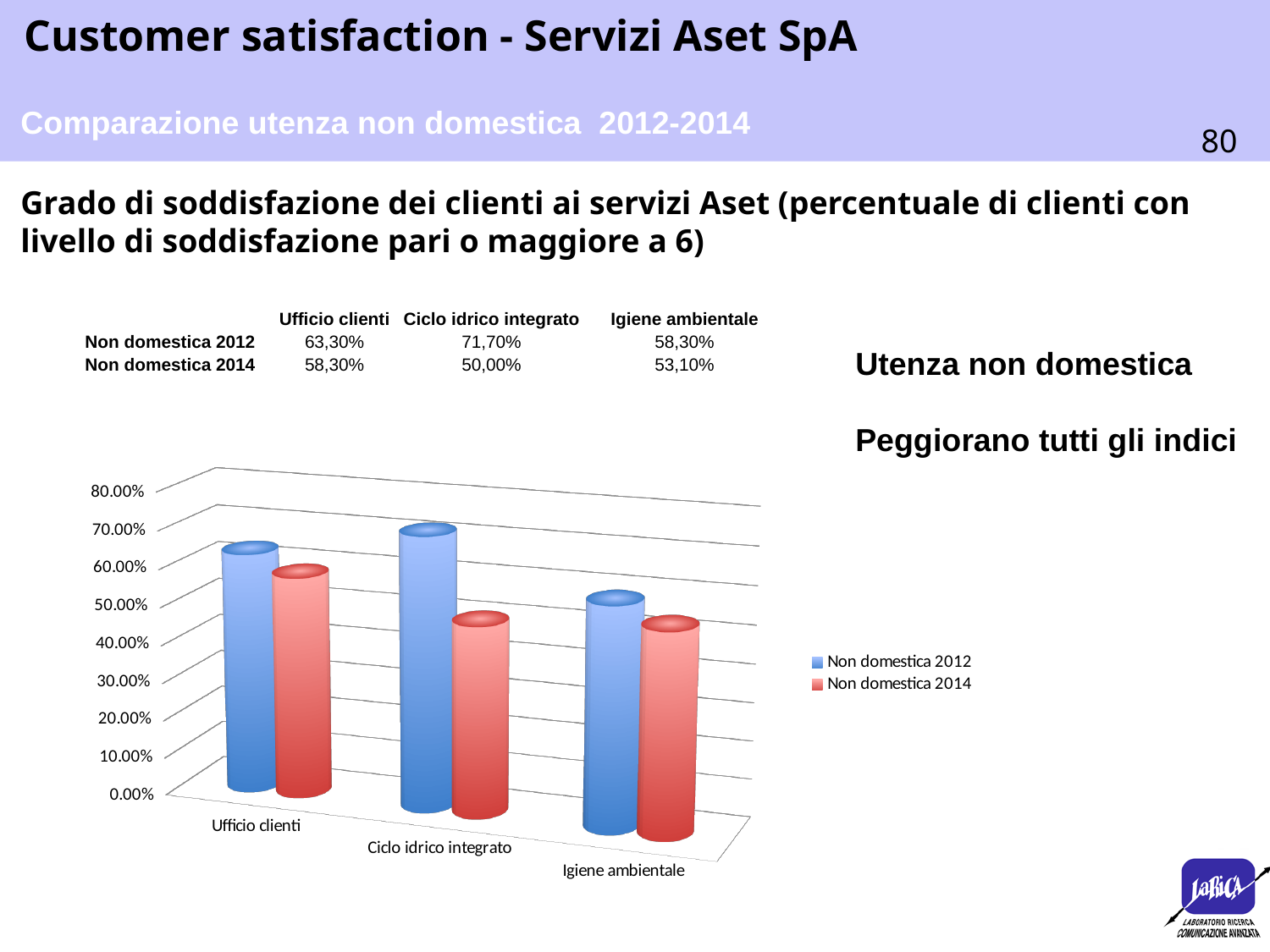
What kind of chart is shown on the slide? bar chart What is the value for Ciclo idrico integrato in the Non domestica 2012 series? 71,70% Which category has the highest value in the Non domestica 2012 series? Ciclo idrico integrato For Ufficio clienti, which series has the larger value, Non domestica 2012 or Non domestica 2014? Non domestica 2012 How many categories are shown on the x axis of the chart? 3 Is the Non domestica 2012 value for Igiene ambientale greater or less than 50.00%? greater Which series is shown in red in the chart? Non domestica 2014 What is the difference between the Non domestica 2012 and Non domestica 2014 values for Ciclo idrico integrato? 21,70% Which category has the lowest value in the Non domestica 2014 series? Ciclo idrico integrato How many series does the chart legend list? 2 What is the value for Ufficio clienti in the Non domestica 2014 series? 58,30% What is the value for Igiene ambientale in the Non domestica 2014 series? 53,10%